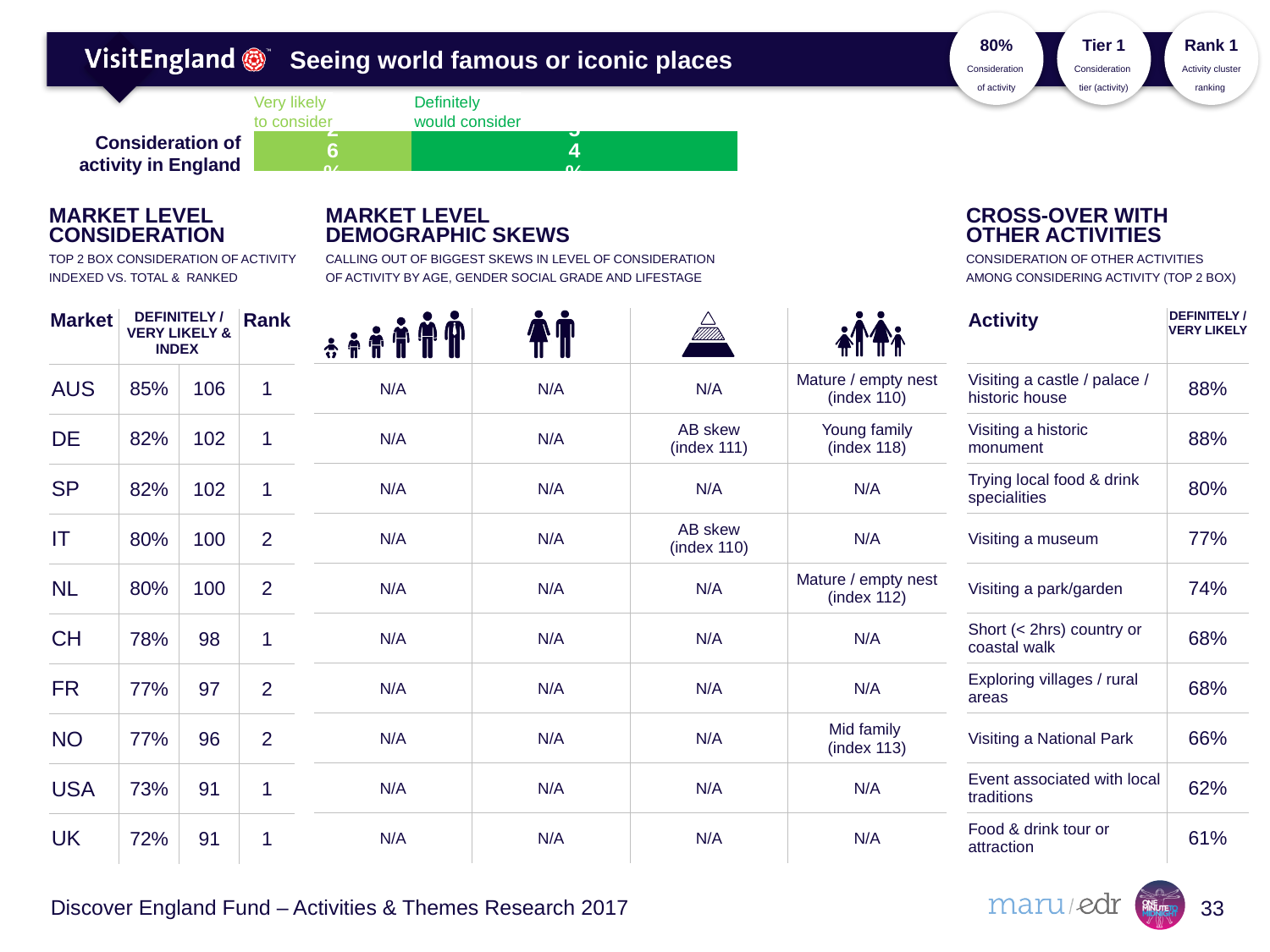
What kind of chart is the 'Consideration of activity in England' chart at the top of the slide? bar chart How many series does the legend of the 'Consideration of activity in England' chart list? 2 In the 'Consideration of activity in England' chart, which segment is larger: 'Very likely to consider' or 'Definitely would consider'? Definitely would consider How many categories are plotted in the 'Consideration of activity in England' chart? 1 In the 'Consideration of activity in England' chart, which series is shown in the darker green colour? Definitely would consider What are the two legend entries of the 'Consideration of activity in England' chart? Very likely to consider; Definitely would consider Is the 'Consideration of activity in England' chart a stacked bar chart? Yes